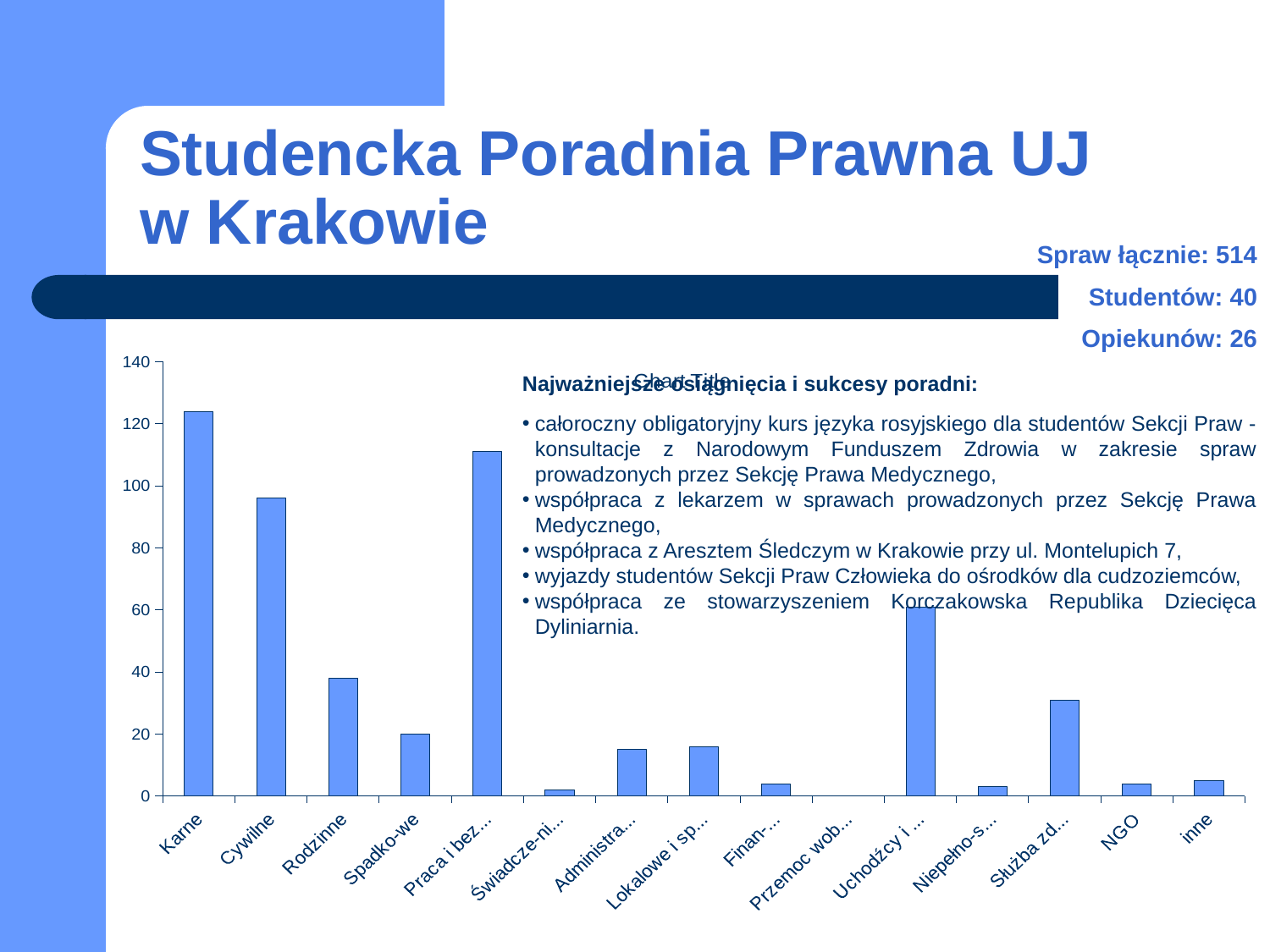
Which is larger, the value for Uchodźcy i ... or the value for Służba zd...? Uchodźcy i ... What kind of chart is shown on the slide? bar chart How many categories are shown on the x axis of the chart? 15 Which is larger, the value for Karne or the value for Cywilne? Karne Is the value for Uchodźcy i ... greater or less than 40? greater Is the value for NGO greater or less than 20? less Which category has the highest bar in the chart? Karne Is the value for Służba zd... greater or less than 20? greater Which is larger, the value for Rodzinne or the value for Spadko-we? Rodzinne